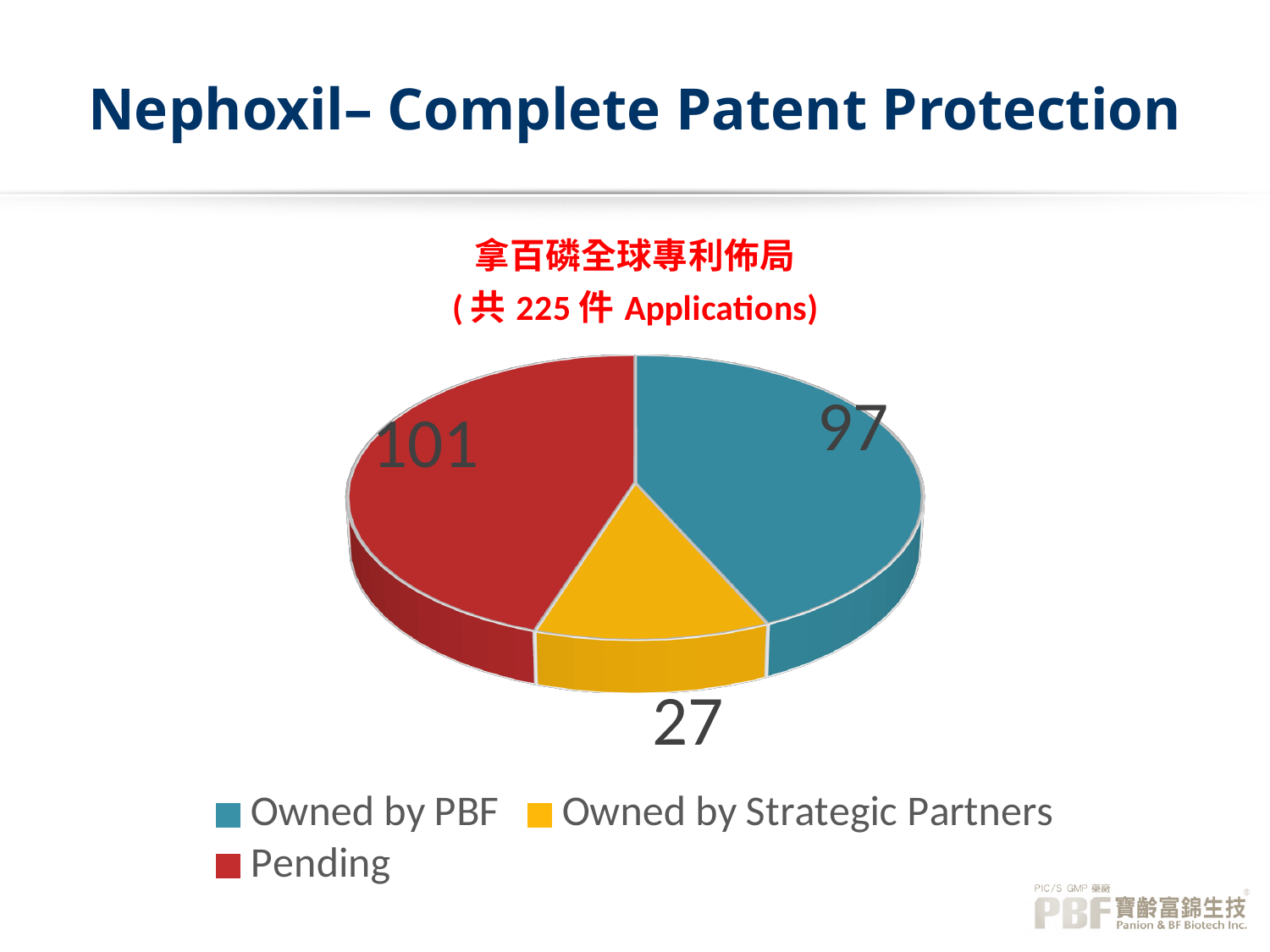
What is the difference between the number of Pending applications and those Owned by PBF? 4 How many applications are Owned by Strategic Partners? 27 Which category has the smallest slice of the pie? Owned by Strategic Partners What share of the total applications is Owned by Strategic Partners? 12% How many applications are Pending? 101 How many slices does the pie chart have? 3 What is the difference between the number of applications Owned by PBF and those Owned by Strategic Partners? 70 Which is larger: the number Owned by PBF or the number Owned by Strategic Partners? Owned by PBF Which category has the largest slice of the pie? Pending How many applications are Owned by PBF? 97 What kind of chart is shown on the slide? pie chart What colour is the Pending slice of the pie? red